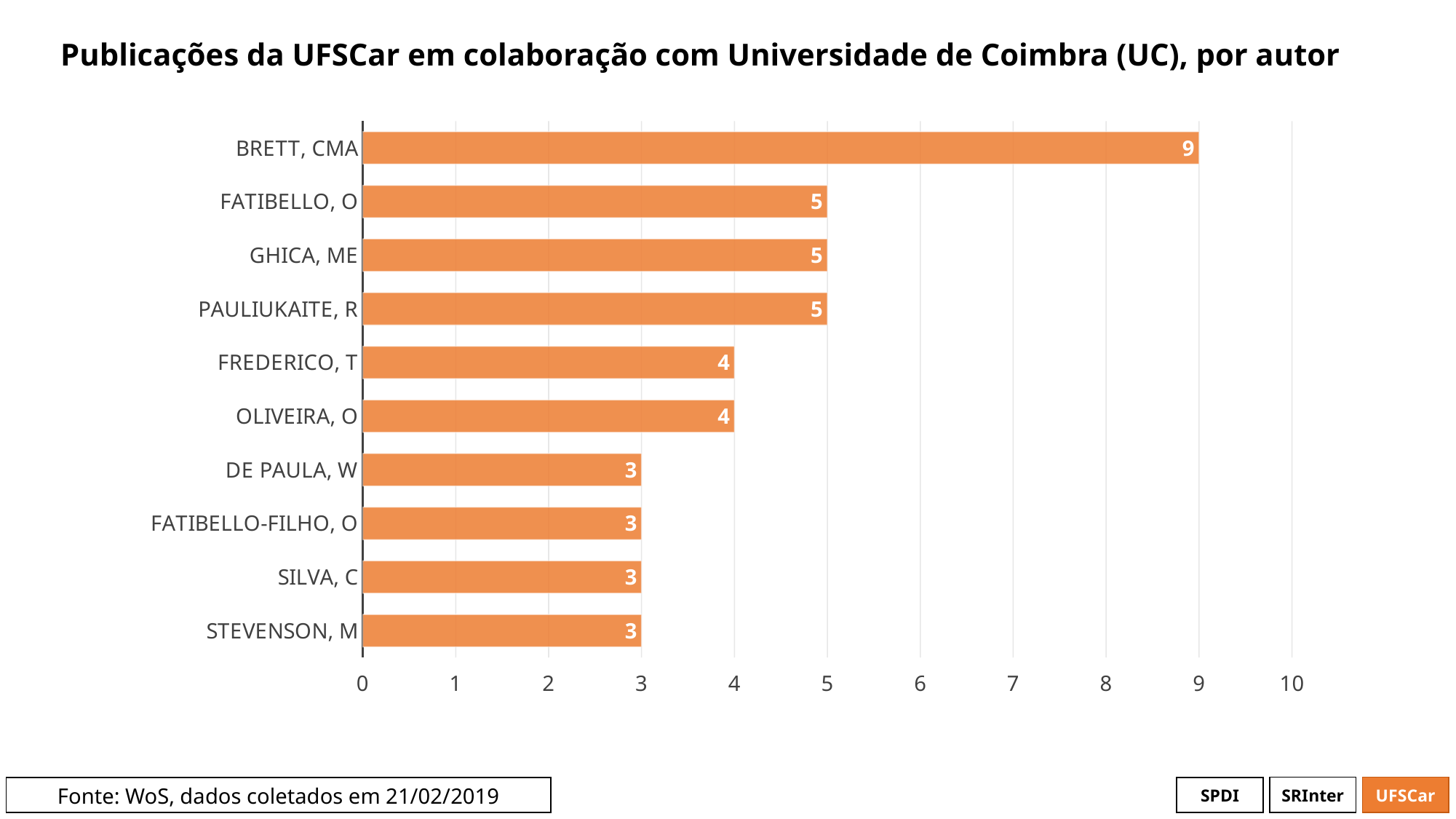
Which author has the highest number of publications? BRETT, CMA What is the title of the chart? Publicações da UFSCar em colaboração com Universidade de Coimbra (UC), por autor Is the value for BRETT, CMA greater or less than 8? greater Which is larger, the value for PAULIUKAITE, R or the value for OLIVEIRA, O? PAULIUKAITE, R What is the difference between the values for BRETT, CMA and FATIBELLO, O? 4 How many authors have exactly 3 publications? 4 How many publications does BRETT, CMA have? 9 What is the value for FREDERICO, T? 4 What kind of chart is shown on the slide? bar chart What is the value for STEVENSON, M? 3 What is the difference between the values for GHICA, ME and DE PAULA, W? 2 How many authors are shown in the chart? 10